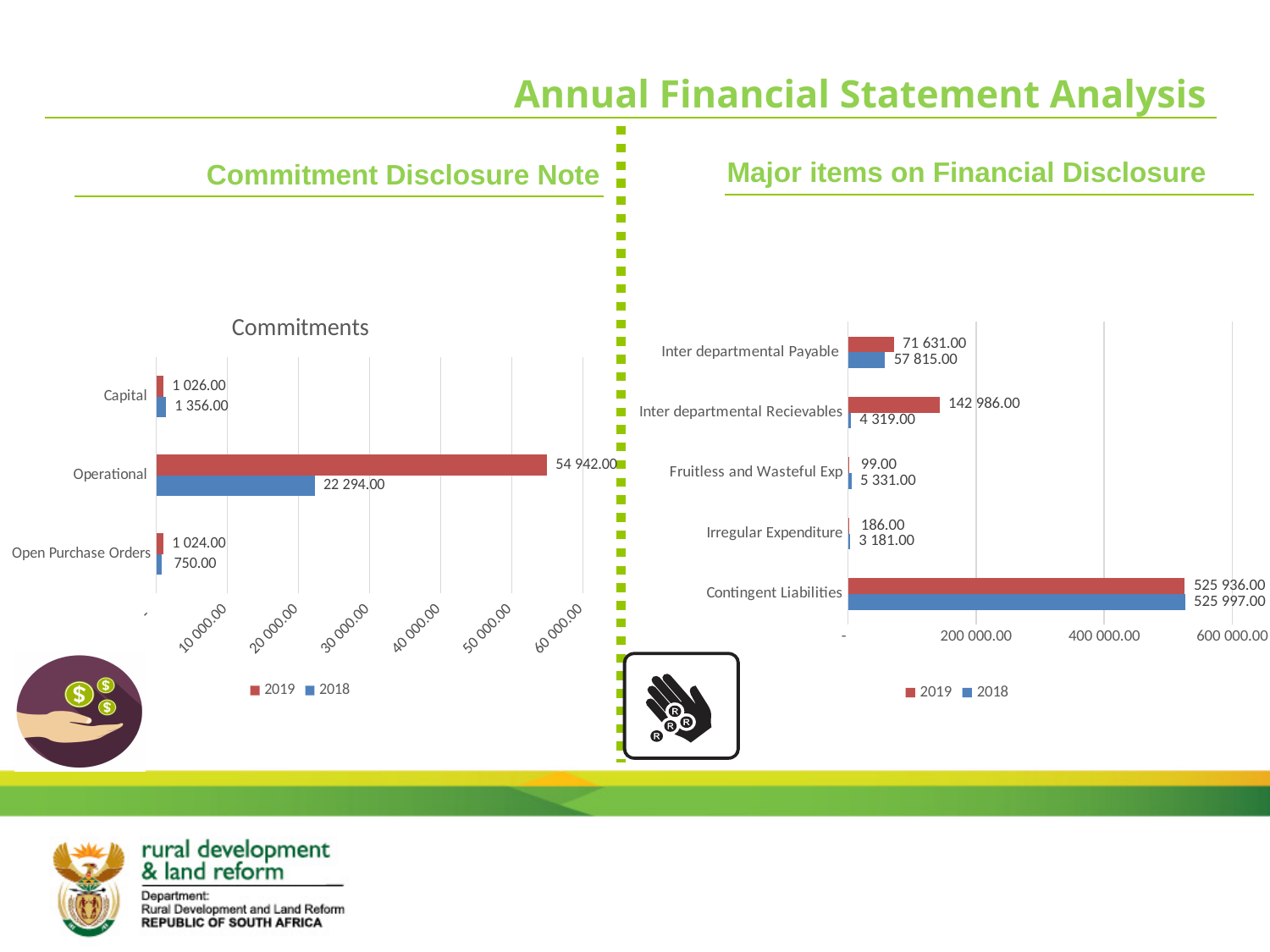
In the Major items on Financial Disclosure chart, what is the difference between the 2019 and 2018 values for Inter departmental Payable? 13 816.00 In the Major items on Financial Disclosure chart, which category has the lowest 2019 value? Fruitless and Wasteful Exp How many categories are shown in the Commitments chart? 3 In the Commitments chart, is the 2019 value for Capital larger or smaller than the 2018 value for Capital? smaller In the Major items on Financial Disclosure chart, what is the 2018 value for Fruitless and Wasteful Exp? 5 331.00 In the Commitments chart, what is the 2019 value for Operational? 54 942.00 How many series does the legend of the Major items on Financial Disclosure chart list? 2 In the Commitments chart, what is the difference between the 2019 and 2018 values for Operational? 32 648.00 In the Major items on Financial Disclosure chart, what is the 2019 value for Inter departmental Recievables? 142 986.00 How many categories are shown in the Major items on Financial Disclosure chart? 5 In the Commitments chart, what is the 2018 value for Open Purchase Orders? 750.00 In the Commitments chart, which category has the highest 2019 value? Operational